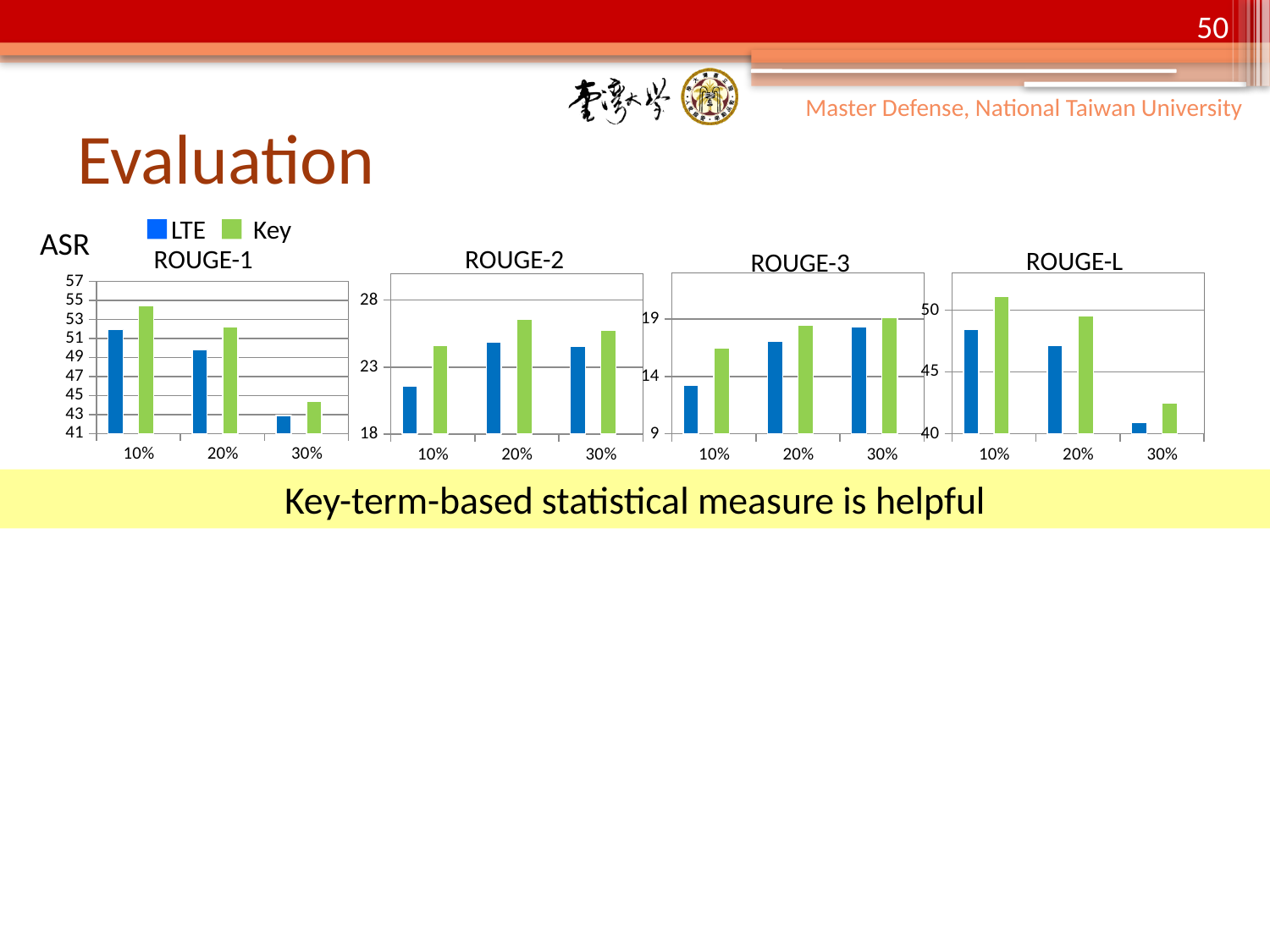
In the ROUGE-2 chart, is the LTE value at 10% greater or less than 23? less Which series is shown in green in the charts? Key In the ROUGE-2 chart, at which category is the Key series highest? 20% In the ROUGE-L chart, is the Key value at 10% greater or less than 50? greater In the ROUGE-1 chart, is the LTE value at 30% greater or less than 45? less In the ROUGE-3 chart, does the LTE series rise or fall from 10% to 30%? rise In the ROUGE-1 chart, which is larger at 10%, LTE or Key? Key What kind of chart is the ROUGE-1 chart? bar chart How many categories are shown on the x axis of the ROUGE-2 chart? 3 In the ROUGE-L chart, does the LTE series rise or fall from 10% to 30%? fall How many series does the legend list for the charts? 2